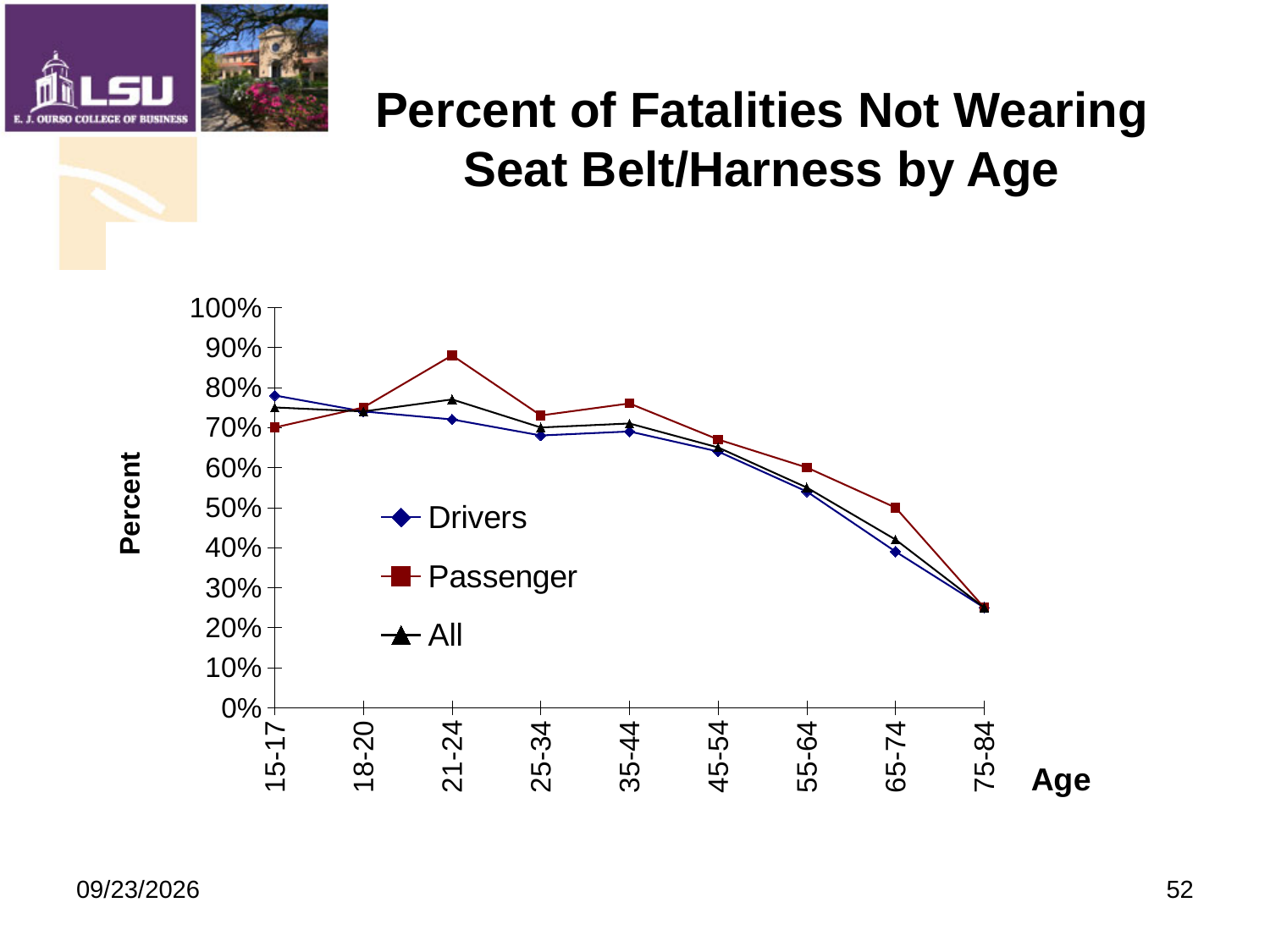
Is the Passenger value for age 45-54 greater or less than 60%? greater How many age groups are shown on the x axis? 9 Overall, do the values for the All series rise or fall as age increases along the x axis? Fall Which age group has the highest value for the Passenger series? 21-24 How many series does the legend list? 3 At age 21-24, which is larger: the Passenger value or the Drivers value? Passenger Is the Passenger value for age 21-24 greater or less than 80%? greater Which age group has the lowest value for the Drivers series? 75-84 What kind of chart is shown on the slide? Line chart What is the title of the chart? Percent of Fatalities Not Wearing Seat Belt/Harness by Age At age 15-17, which is larger: the Drivers value or the Passenger value? Drivers Is the Drivers value for age 65-74 greater or less than 50%? less